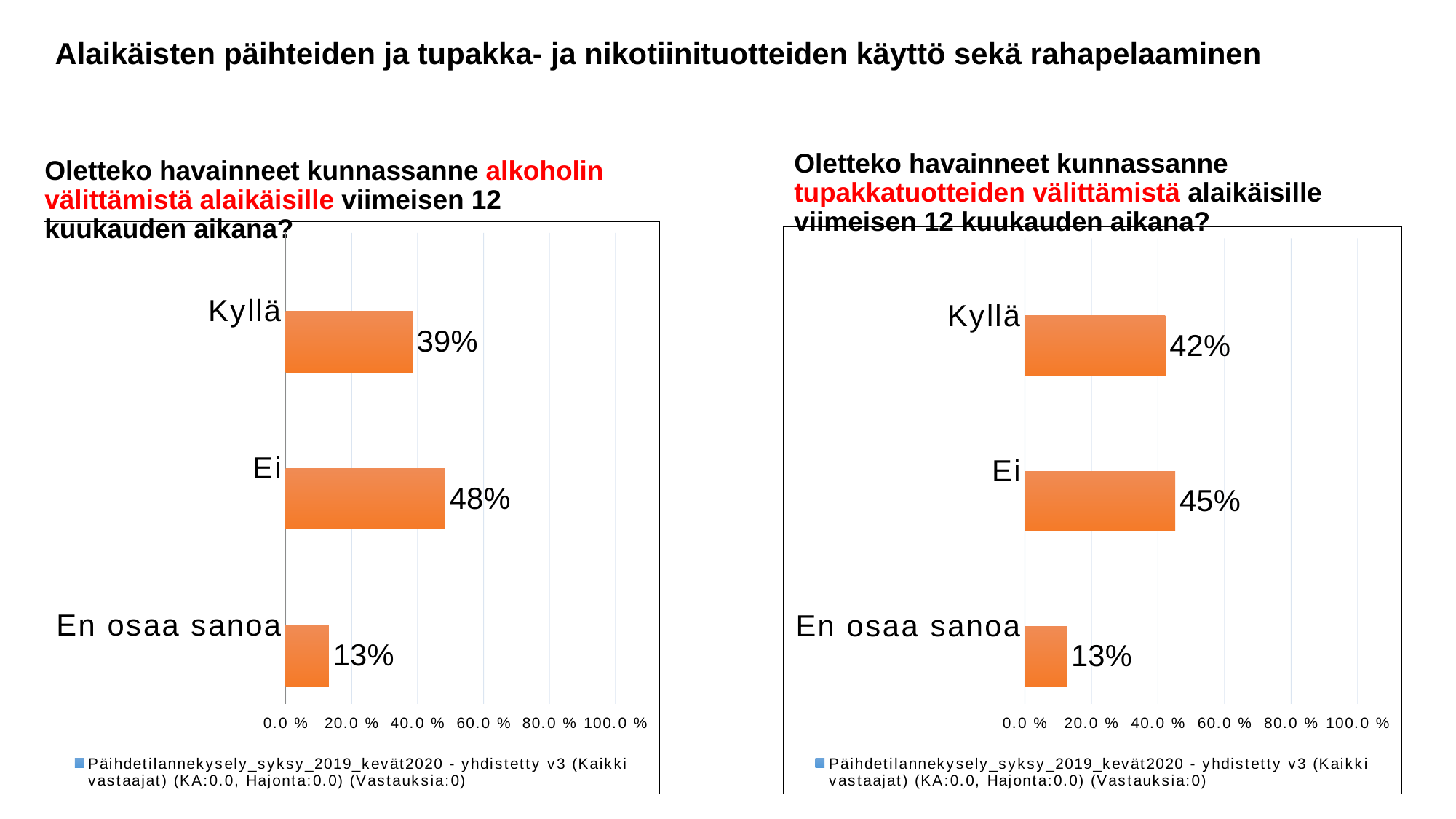
Which is larger: Kyllä in the left chart (alcohol) or Kyllä in the right chart (tobacco products)? Kyllä in the right chart (tobacco products) In the right chart (tobacco products), what is the value for En osaa sanoa? 13% In the right chart (tobacco products), what is the value for Kyllä? 42% How many categories does the left chart (alcohol) show? 3 In the right chart (tobacco products), which category has the lowest value? En osaa sanoa In the left chart (alcohol), is the value for Ei greater or less than 40.0 %? greater In the right chart (tobacco products), what is the difference between Ei and Kyllä? 3% In the left chart (alcohol), what is the value for Ei? 48% What kind of chart is the right chart (tobacco products)? Bar chart In the left chart (alcohol), what is the difference between Ei and Kyllä? 9% In the left chart (alcohol), what is the value for Kyllä? 39% In the left chart (alcohol), which category has the highest value? Ei